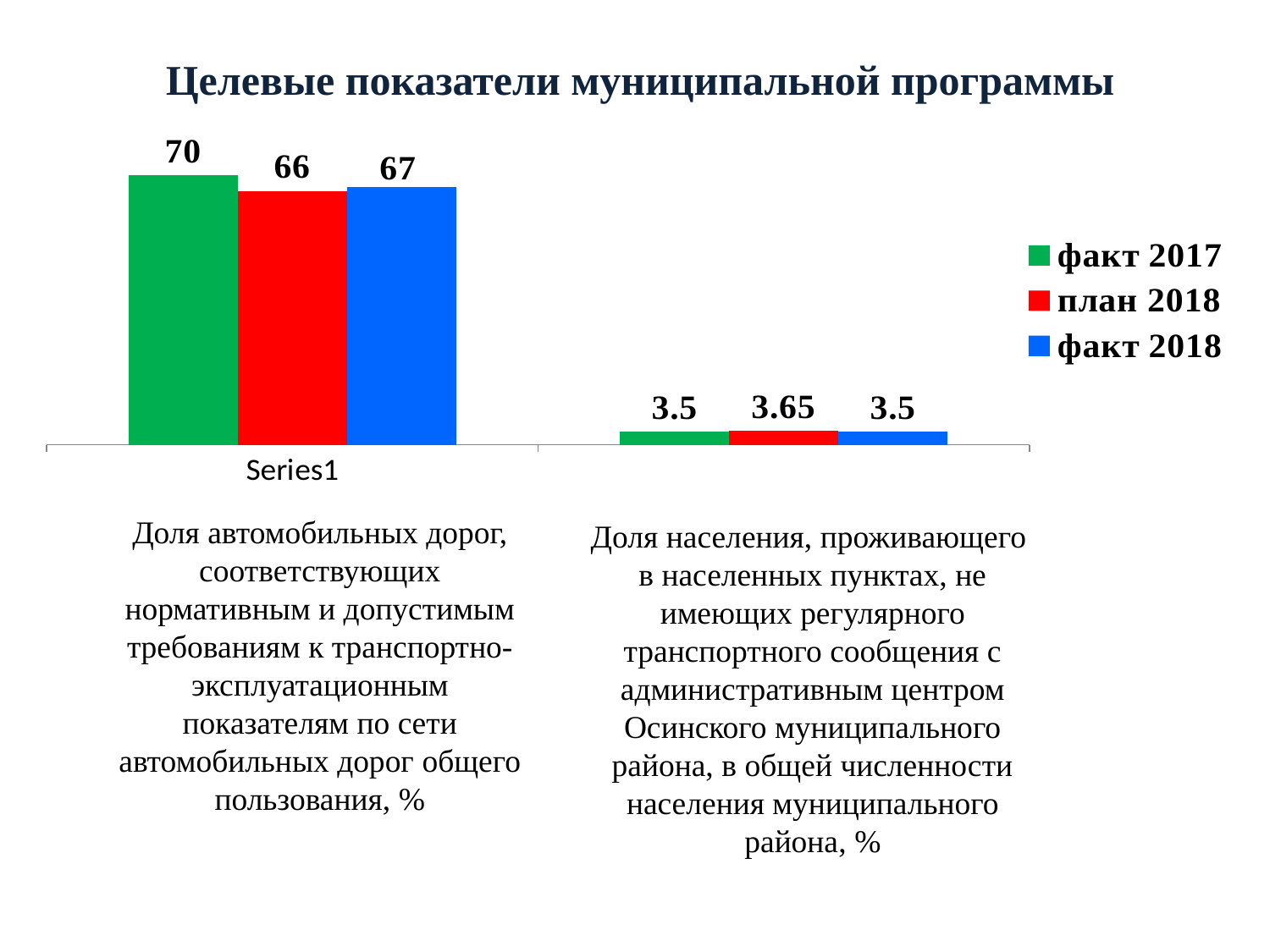
In the left group of bars, which series has the lowest value? план 2018 What is the difference between факт 2017 and факт 2018 in the left group of bars? 3 What type of chart is shown on the slide? bar chart Which colour represents факт 2018 in the legend? blue What is the value of факт 2018 for the right group of bars (share of population without regular transport links)? 3.5 What is the value of факт 2017 for the left group of bars (share of roads meeting standards)? 70 In the left group of bars, which series has the highest value? факт 2017 How many series does the legend list? 3 What is the value of план 2018 for the left group of bars (share of roads meeting standards)? 66 What is the value of факт 2018 for the left group of bars (share of roads meeting standards)? 67 In the right group of bars, which is larger: план 2018 or факт 2018? план 2018 What is the value of план 2018 for the right group of bars (share of population without regular transport links)? 3.65